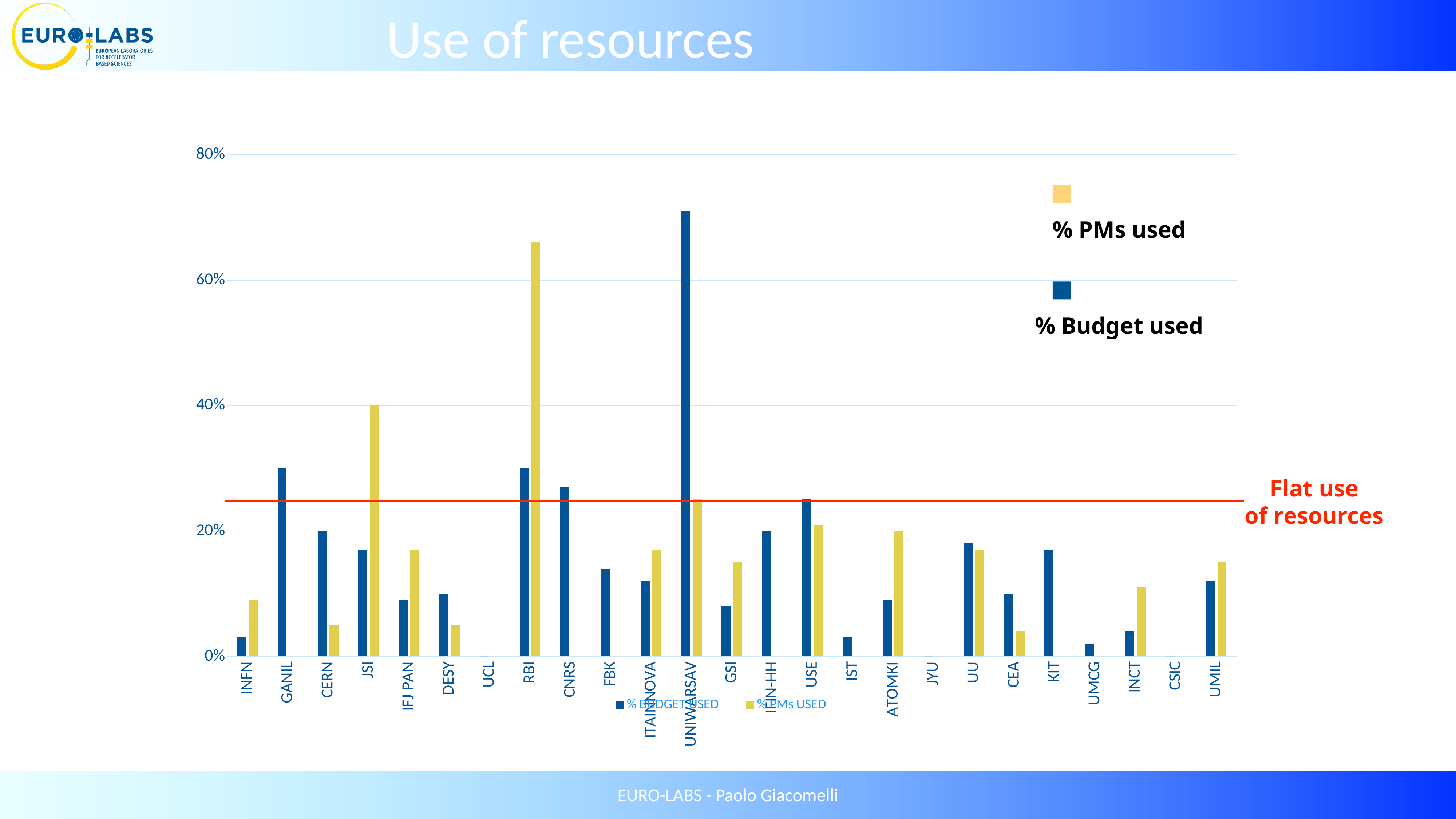
Is the % BUDGET USED value for GANIL greater or less than 40%? less Which is larger for JSI: the % BUDGET USED bar or the % PMs USED bar? % PMs USED Which institution has the highest % BUDGET USED bar? UNIWARSAV Is the % PMs USED value for RBI greater or less than 60%? greater Which institution has the highest % PMs USED bar? RBI How many series does the chart's legend list? 2 Is the % PMs USED value for INFN greater or less than 20%? less What kind of chart is shown on the slide? bar chart What does the red horizontal line on the chart represent, according to its label? Flat use of resources How many institutions are listed along the x axis of the chart? 25 Which institution has the larger % BUDGET USED bar, GANIL or CERN? GANIL